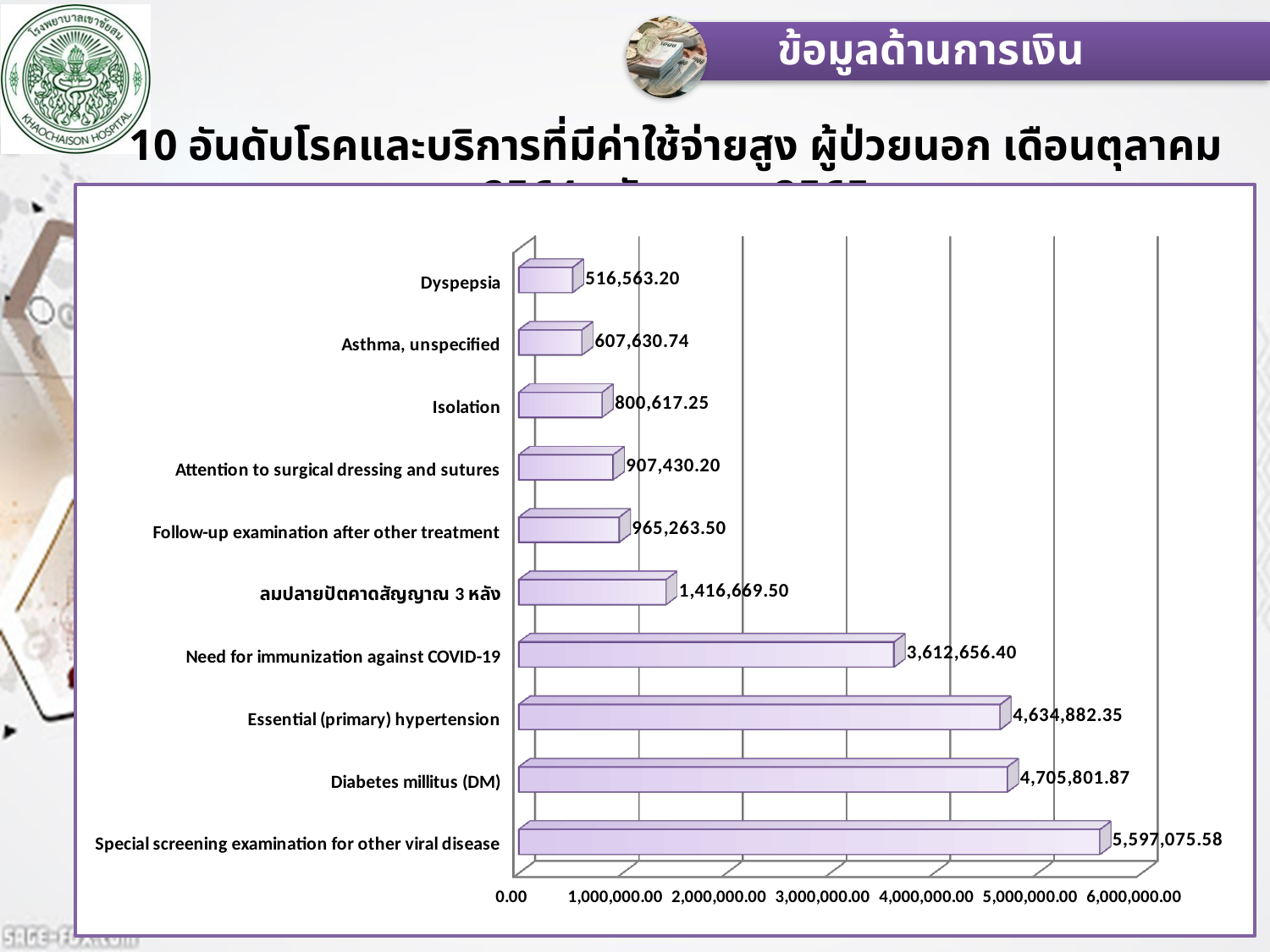
What is the difference between the values for Asthma, unspecified and Dyspepsia? 91,067.54 What is the difference between the values for Special screening examination for other viral disease and Diabetes millitus (DM)? 891,273.71 How many categories are shown in the chart? 10 Is the value for Follow-up examination after other treatment greater or less than 1,000,000.00? less What is the value for Essential (primary) hypertension? 4,634,882.35 Which category has the highest value? Special screening examination for other viral disease Which is larger, the value for Need for immunization against COVID-19 or the value for Essential (primary) hypertension? Essential (primary) hypertension What kind of chart is shown on the slide? Bar chart What is the value for Need for immunization against COVID-19? 3,612,656.40 What is the value for Dyspepsia? 516,563.20 What is the value for Isolation? 800,617.25 Which category has the lowest value? Dyspepsia